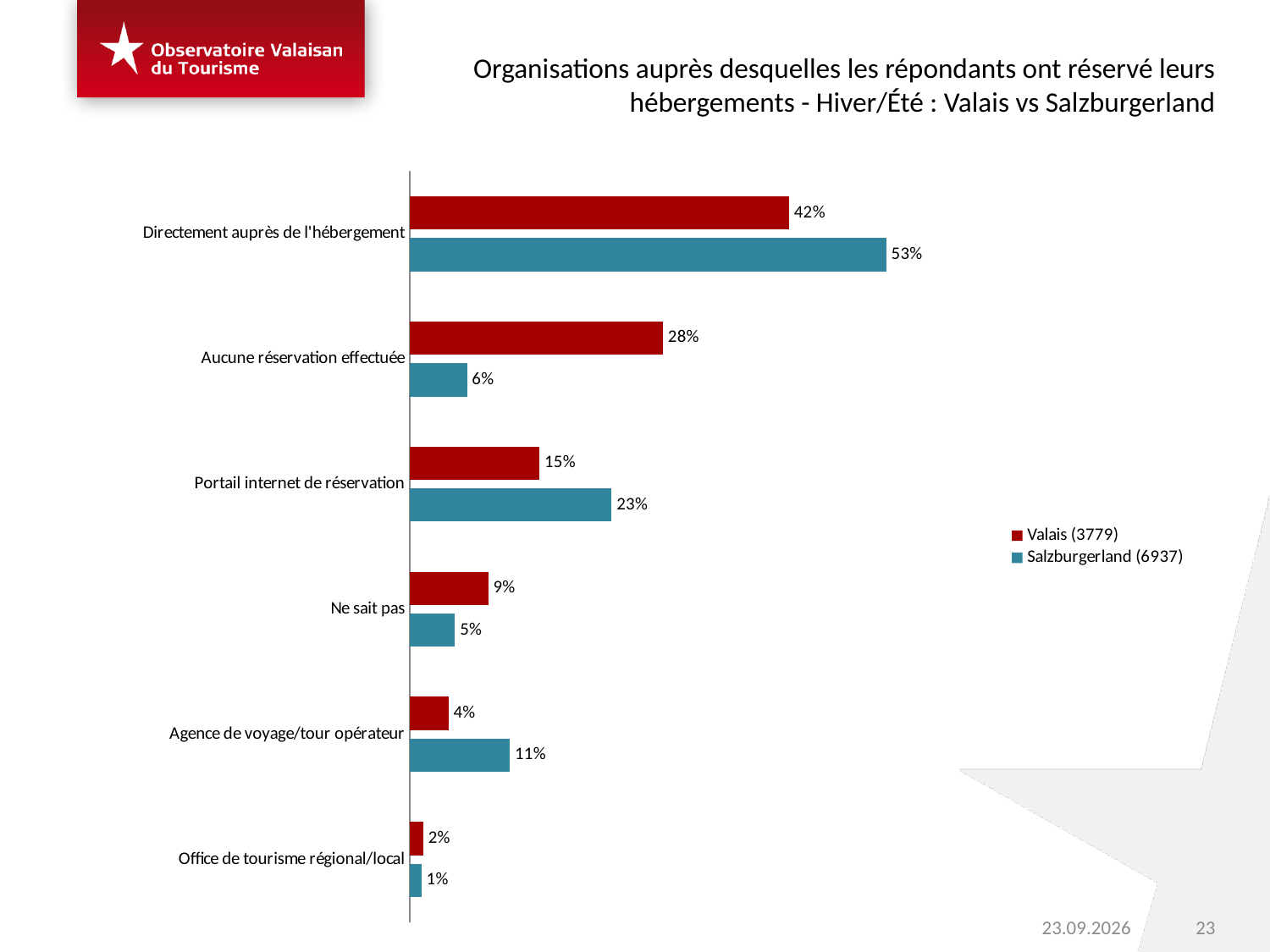
What kind of chart is shown on the slide? Bar chart Which series has the larger value for 'Agence de voyage/tour opérateur'? Salzburgerland (6937) What is the difference between the Salzburgerland (6937) and Valais (3779) values for 'Directement auprès de l'hébergement'? 11% Which category has the highest value for Salzburgerland (6937)? Directement auprès de l'hébergement How many categories are shown on the chart? 6 What is the value for Salzburgerland (6937) for 'Aucune réservation effectuée'? 6% How many series does the legend list? 2 Which category has the lowest value for Valais (3779)? Office de tourisme régional/local Which series has the larger value for 'Ne sait pas'? Valais (3779) What is the value for Valais (3779) for 'Directement auprès de l'hébergement'? 42% What is the value for Salzburgerland (6937) for 'Portail internet de réservation'? 23% What is the difference between the Valais (3779) and Salzburgerland (6937) values for 'Aucune réservation effectuée'? 22%